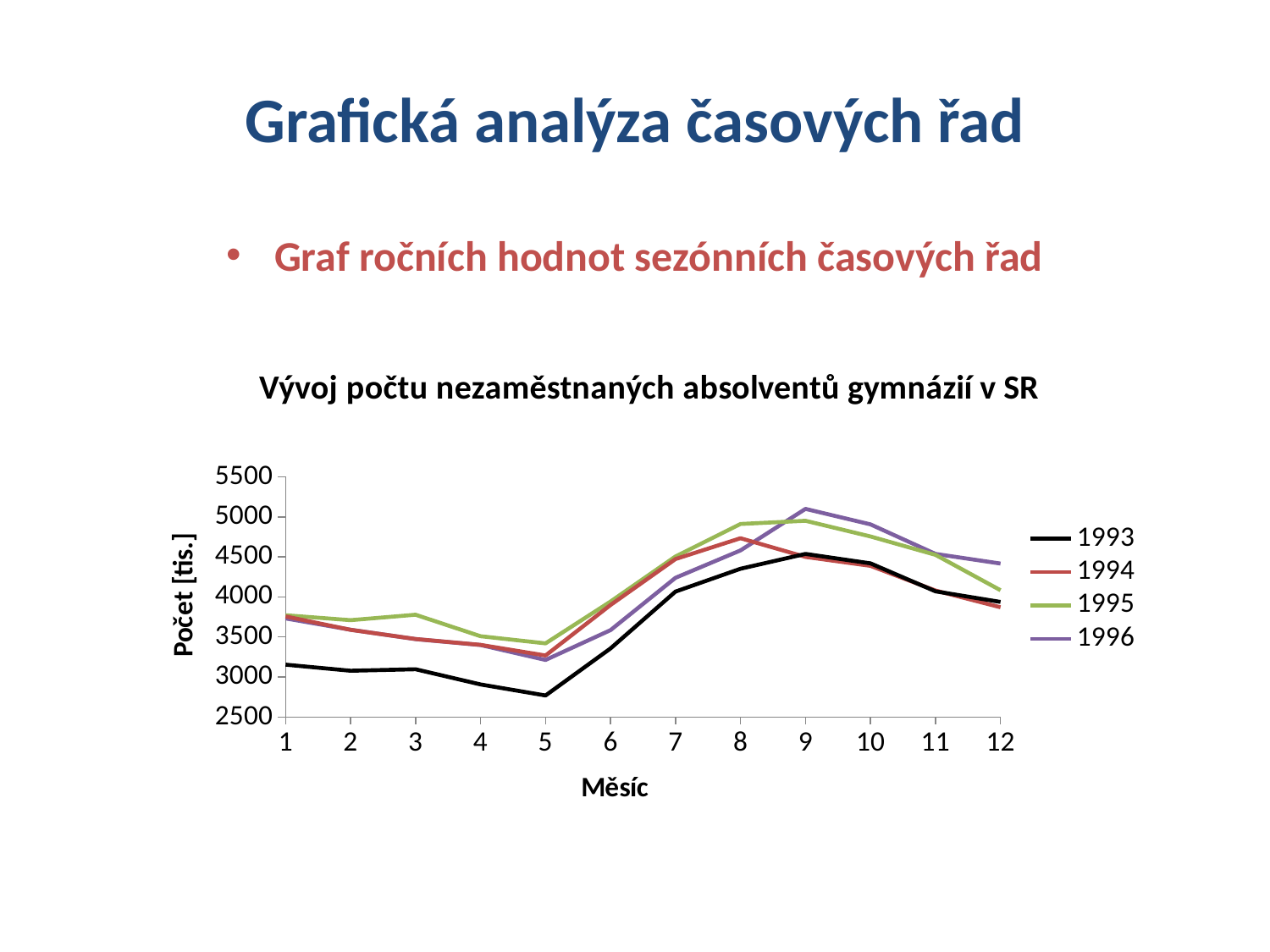
Which series has the lowest value in month 1? 1993 What is the title of the chart? Vývoj počtu nezaměstnaných absolventů gymnázií v SR How many series does the legend of the chart list? 4 How many months are shown on the x axis of the chart? 12 What kind of chart is shown on the slide? line chart Is the value for 1993 in month 5 greater or less than 3000? less What is the label of the vertical axis of the chart? Počet [tis.] Which series has the highest value in month 9? 1996 Does the 1993 series rise or fall from month 5 to month 9? rise Is the value for 1996 in month 9 greater or less than 5000? greater Is the value for 1995 in month 8 greater or less than 4500? greater In month 5, which series has the larger value, 1993 or 1995? 1995